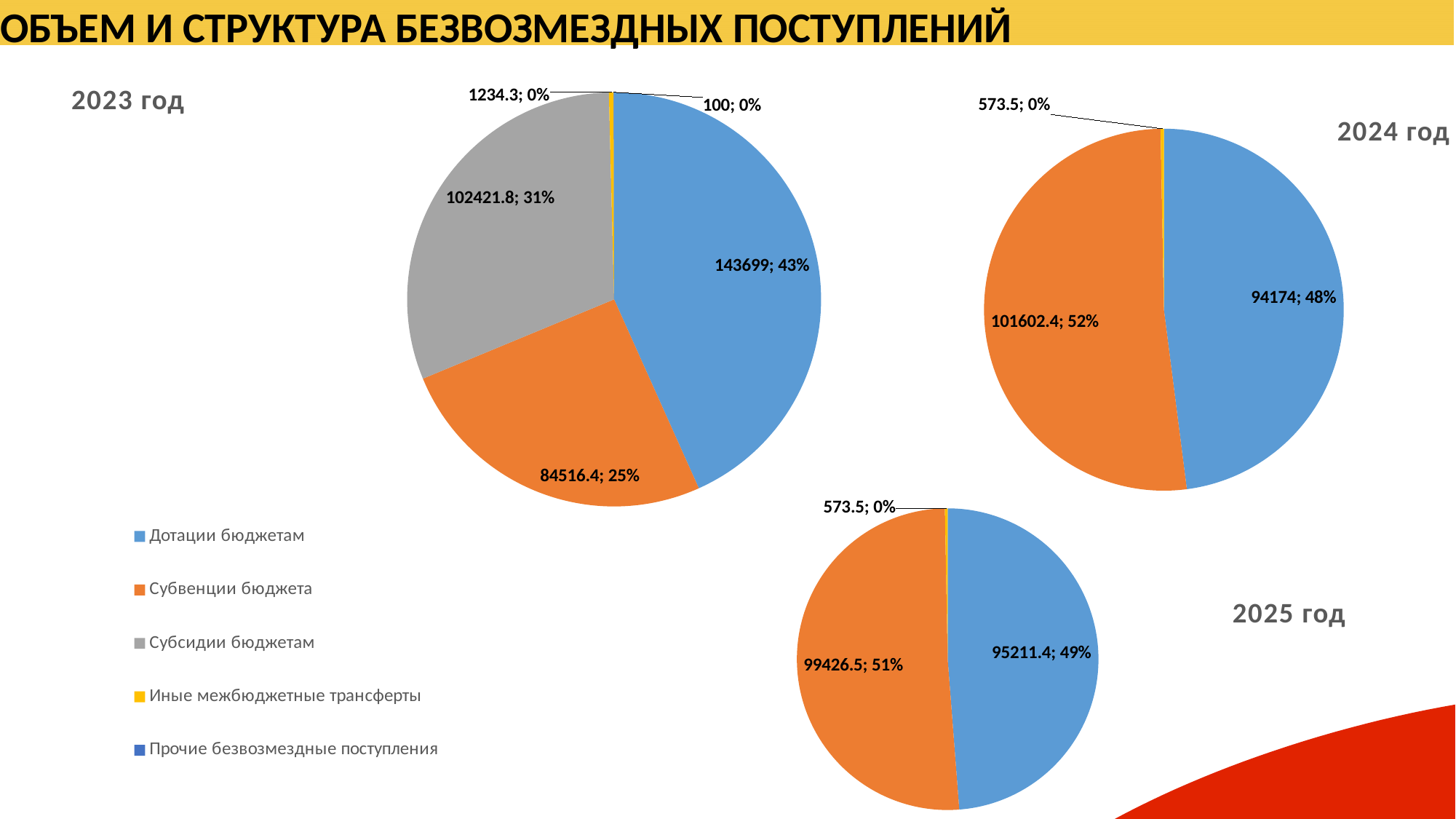
In the 2025 год pie chart, what share of the pie does Субвенции бюджета have? 51% In the 2023 год pie chart, what is the value for Субвенции бюджета? 84516.4 In the 2024 год pie chart, what share of the pie does Дотации бюджетам have? 48% What kind of chart is used for the 2025 год data? Pie chart In the 2023 год pie chart, what share of the pie does Субсидии бюджетам have? 31% In the 2025 год pie chart, what is the value for Дотации бюджетам? 95211.4 In the 2024 год pie chart, what is the value for Субвенции бюджета? 101602.4 In the 2023 год pie chart, what is the value for Дотации бюджетам? 143699 How many entries does the legend on the slide list? 5 In the 2024 год pie chart, which is larger, Дотации бюджетам or Субвенции бюджета? Субвенции бюджета In the 2023 год pie chart, what is the difference between the values for Дотации бюджетам and Субсидии бюджетам? 41277.2 In the 2023 год pie chart, which category has the largest slice? Дотации бюджетам